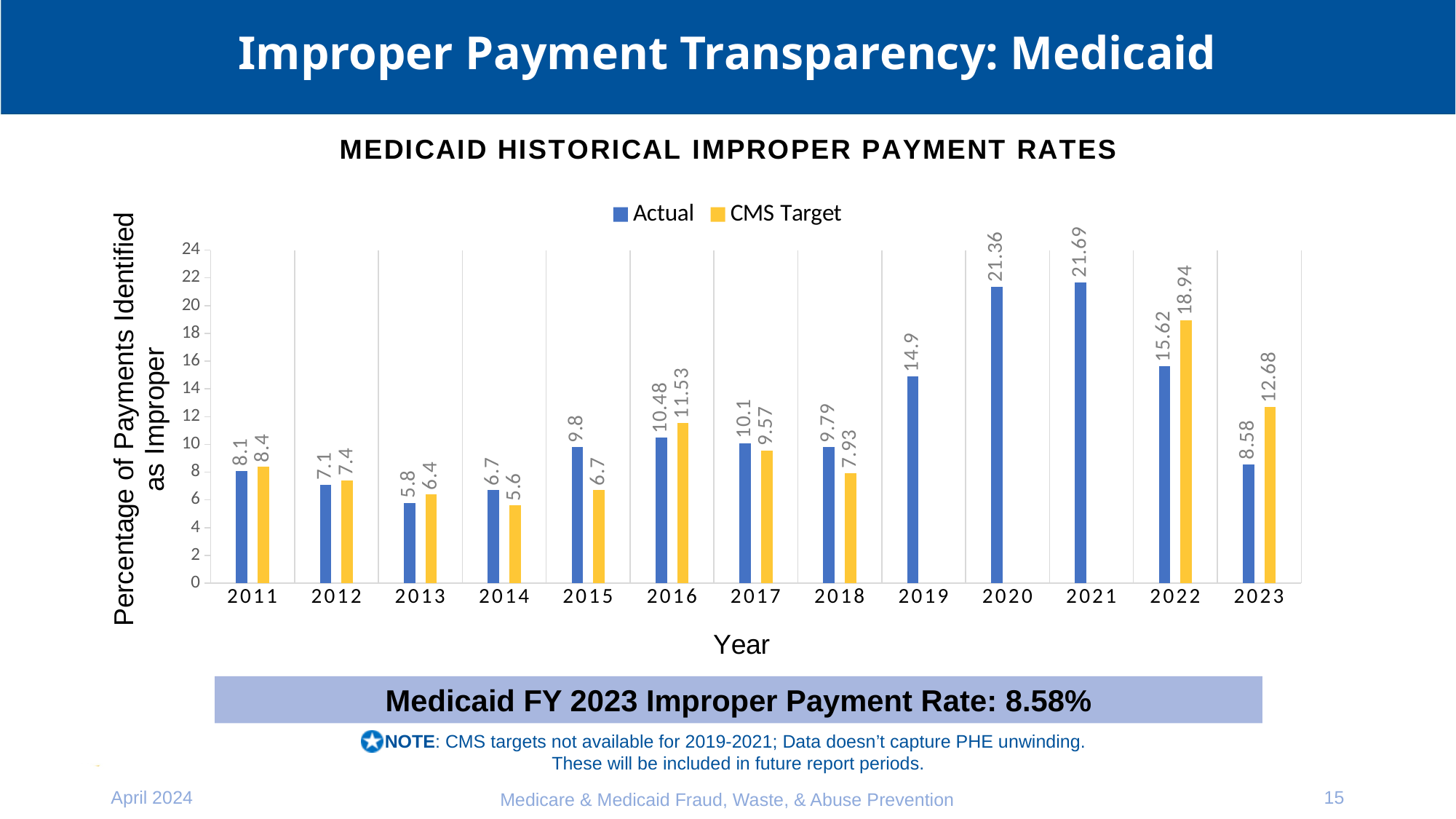
What is the title of the chart? MEDICAID HISTORICAL IMPROPER PAYMENT RATES How many years are shown on the x axis? 13 Which year has the highest Actual improper payment rate? 2021 What is the CMS Target value for 2022? 18.94 What is the difference between the CMS Target and the Actual value for 2023? 4.1 What is the Actual improper payment rate for 2020? 21.36 Is the Actual value for 2019 greater or less than 14? greater Which year has the lowest Actual improper payment rate? 2013 What kind of chart is shown on the slide? Bar chart Which is larger for 2018, the Actual value or the CMS Target? Actual How many series does the legend list? 2 What is the Actual value for 2013? 5.8